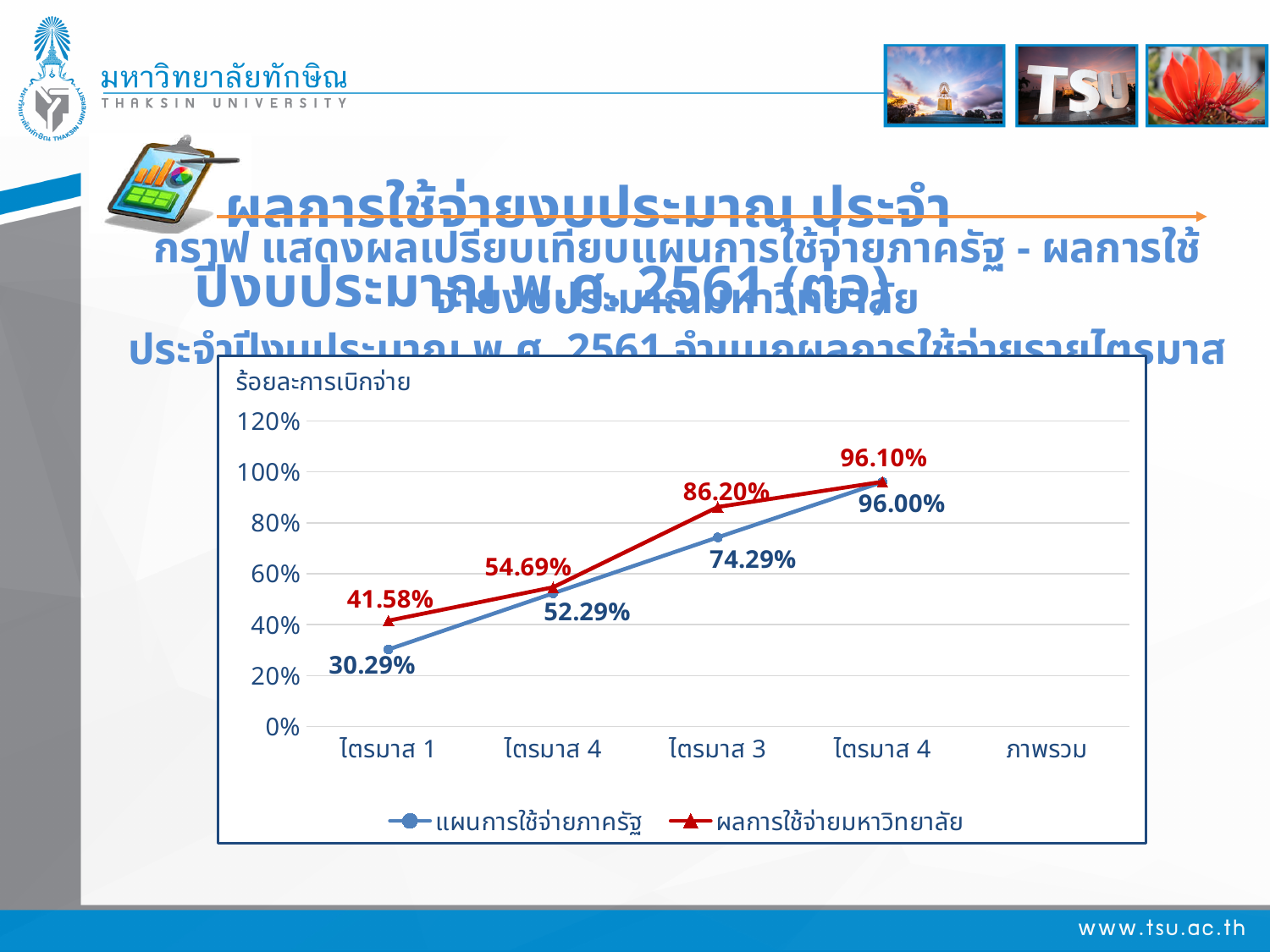
What is the value of ผลการใช้จ่ายมหาวิทยาลัย for ไตรมาส 3? 86.20% How many categories are shown on the x axis? 5 What kind of chart is shown on the slide? line chart Which series has the higher value for ไตรมาส 3, แผนการใช้จ่ายภาครัฐ or ผลการใช้จ่ายมหาวิทยาลัย? ผลการใช้จ่ายมหาวิทยาลัย Do the values of แผนการใช้จ่ายภาครัฐ rise or fall from ไตรมาส 1 to the fourth category? rise What is the value of แผนการใช้จ่ายภาครัฐ for ไตรมาส 1? 30.29% How many series does the legend list? 2 What is the difference between ผลการใช้จ่ายมหาวิทยาลัย and แผนการใช้จ่ายภาครัฐ for ไตรมาส 1? 11.29% What is the value of ผลการใช้จ่ายมหาวิทยาลัย at the fourth category (the second ไตรมาส 4)? 96.10% What is the value of แผนการใช้จ่ายภาครัฐ for ไตรมาส 3? 74.29% What is the value of ผลการใช้จ่ายมหาวิทยาลัย for ไตรมาส 1? 41.58% What is the label shown on the y axis of the chart? ร้อยละการเบิกจ่าย